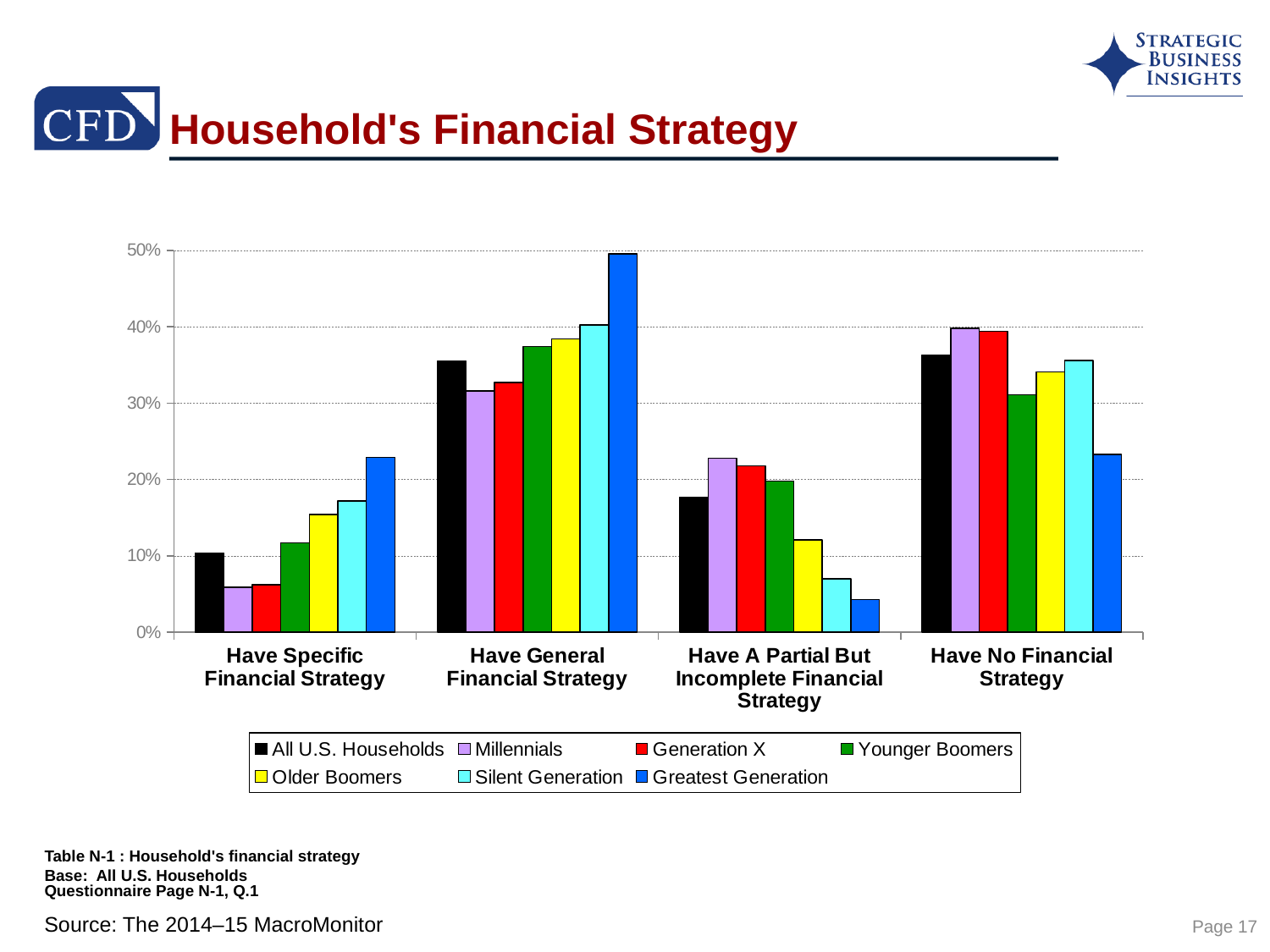
What kind of chart is shown on the slide? bar chart What is the title of the slide's chart? Household's Financial Strategy Is the value for Millennials in the Have Specific Financial Strategy category greater or less than 10%? less In the Have A Partial But Incomplete Financial Strategy category, which series has the lowest bar? Greatest Generation In the Have General Financial Strategy category, which series has the highest bar? Greatest Generation Is the value for Greatest Generation in the Have No Financial Strategy category greater or less than 30%? less Is the value for Greatest Generation in the Have Specific Financial Strategy category greater or less than 20%? greater How many series does the legend list? 7 In the Have A Partial But Incomplete Financial Strategy category, do the bars rise or fall going from Millennials to Greatest Generation? fall For the Greatest Generation series, which category has the highest bar? Have General Financial Strategy In the Have No Financial Strategy category, which is larger: Younger Boomers or Greatest Generation? Younger Boomers How many financial strategy categories are shown on the x axis? 4